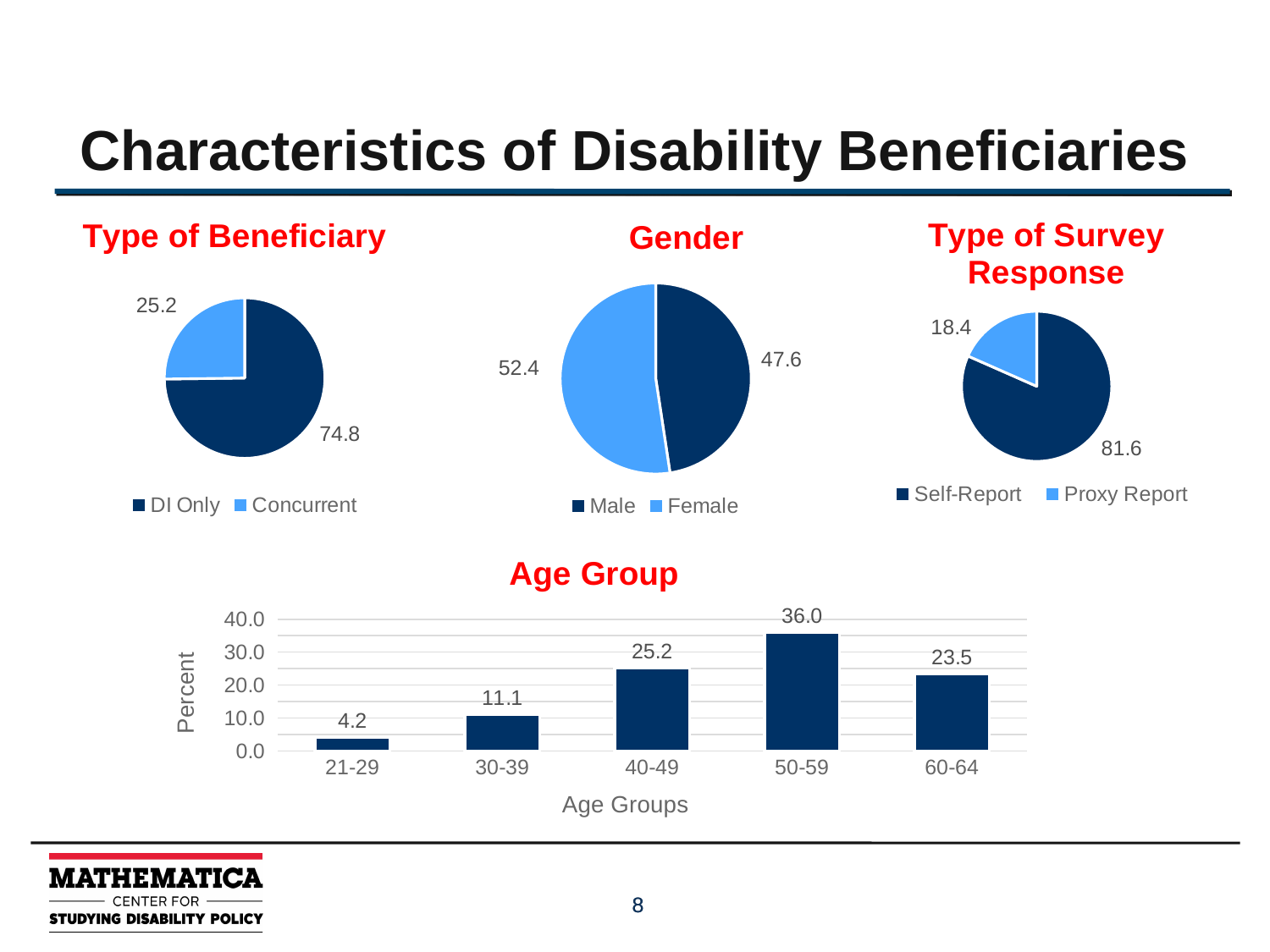
What kind of chart is the Age Group chart? Bar chart In the Gender pie chart, what is the value for Female? 52.4 In the Age Group bar chart, what is the value for the 50-59 age group? 36.0 In the Type of Survey Response pie chart, what is the difference between Self-Report and Proxy Report? 63.2 How many age groups are shown in the Age Group bar chart? 5 In the Age Group bar chart, which age group has the highest value? 50-59 In the Gender pie chart, which is larger, Male or Female? Female In the Type of Beneficiary pie chart, what is the value for DI Only? 74.8 In the Age Group bar chart, what is the difference between the 40-49 and 30-39 age groups? 14.1 In the Type of Survey Response pie chart, what is the value for Proxy Report? 18.4 In the Type of Beneficiary pie chart, what is the value for Concurrent? 25.2 In the Age Group bar chart, which age group has the lowest value? 21-29